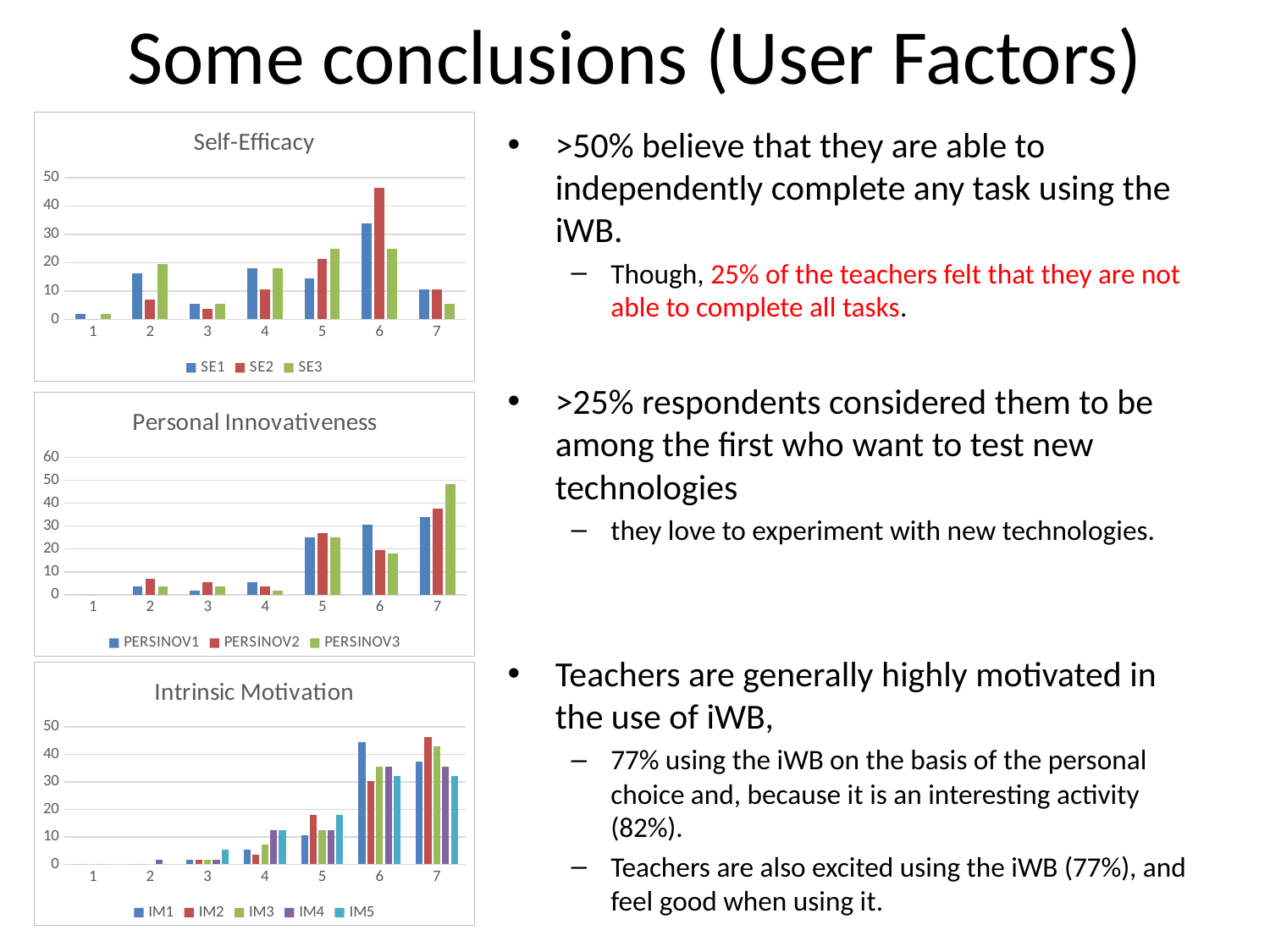
In the Self-Efficacy chart, at category 6, which is larger, SE1 or SE2? SE2 In the Self-Efficacy chart, is the SE2 value for category 6 greater or less than 40? greater In the Personal Innovativeness chart, how many categories are shown on the x axis? 7 In the Personal Innovativeness chart, is the PERSINOV3 value for category 7 greater or less than 40? greater What kind of chart is the Personal Innovativeness chart? bar chart In the Intrinsic Motivation chart, how many series does the legend list? 5 In the Intrinsic Motivation chart, is the IM1 value for category 6 greater or less than 40? greater In the Personal Innovativeness chart, which category has the highest PERSINOV3 value? 7 In the Self-Efficacy chart, which category has the highest SE2 value? 6 In the Self-Efficacy chart, how many series does the legend list? 3 In the Personal Innovativeness chart, at category 7, which is larger, PERSINOV1 or PERSINOV3? PERSINOV3 In the Intrinsic Motivation chart, at category 6, which is larger, IM1 or IM2? IM1